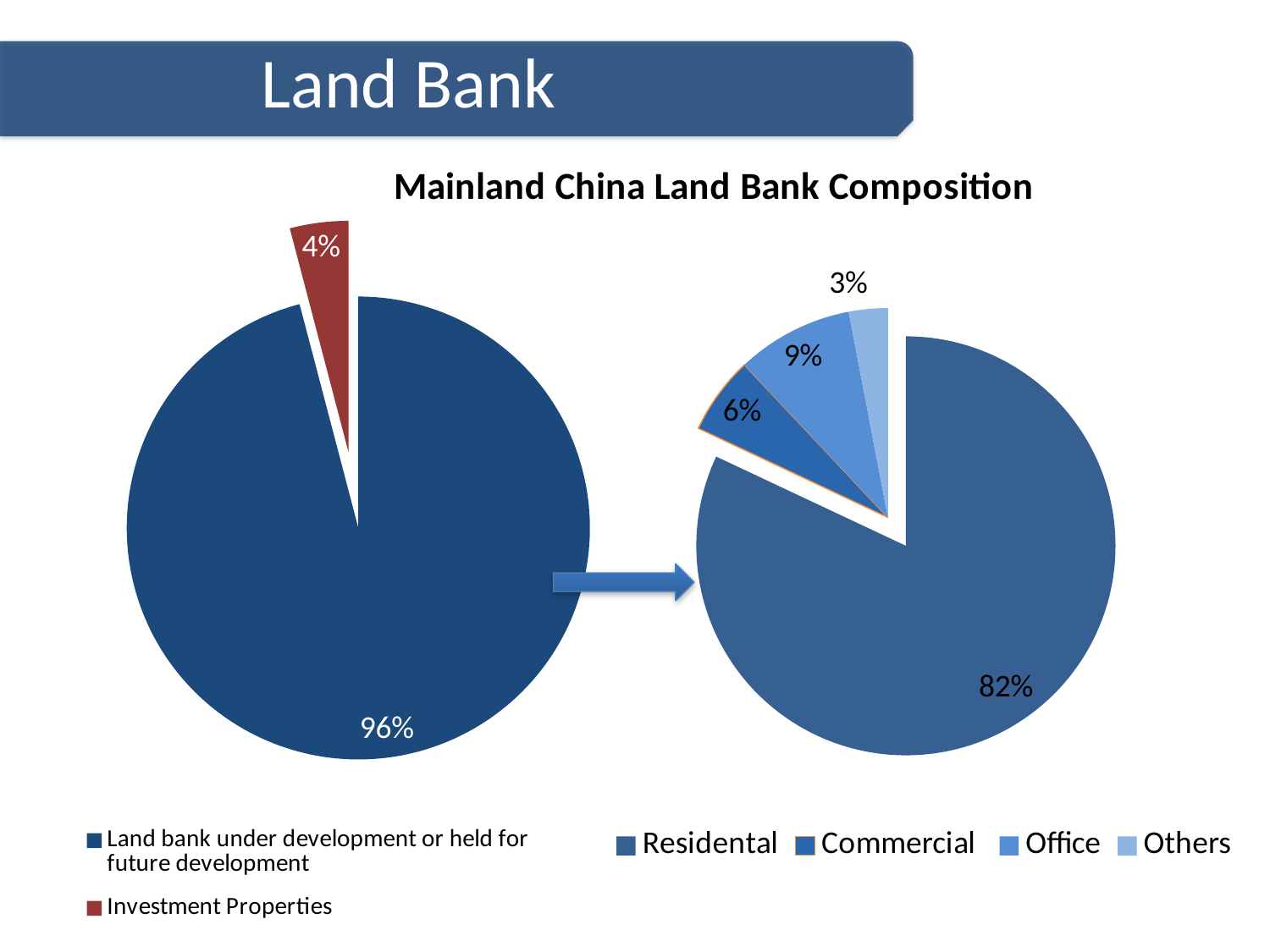
What is the title shown above the charts? Mainland China Land Bank Composition In the right pie chart, which category has the smallest slice? Others How many slices does the right pie chart have? 4 In the right pie chart, which slice is larger, Office or Commercial? Office In the left pie chart, what share is labelled for Investment Properties? 4% In the right pie chart, what is the difference in percentage points between the Office and Commercial slices? 3 In the right pie chart, what share is labelled for Office? 9% In the right pie chart, what share is labelled for Others? 3% What type of chart is the left chart on the slide? Pie chart In the left pie chart, what share is labelled for land bank under development or held for future development? 96% In the right pie chart, what share is labelled for Commercial? 6% In the right pie chart, which category has the largest slice? Residental